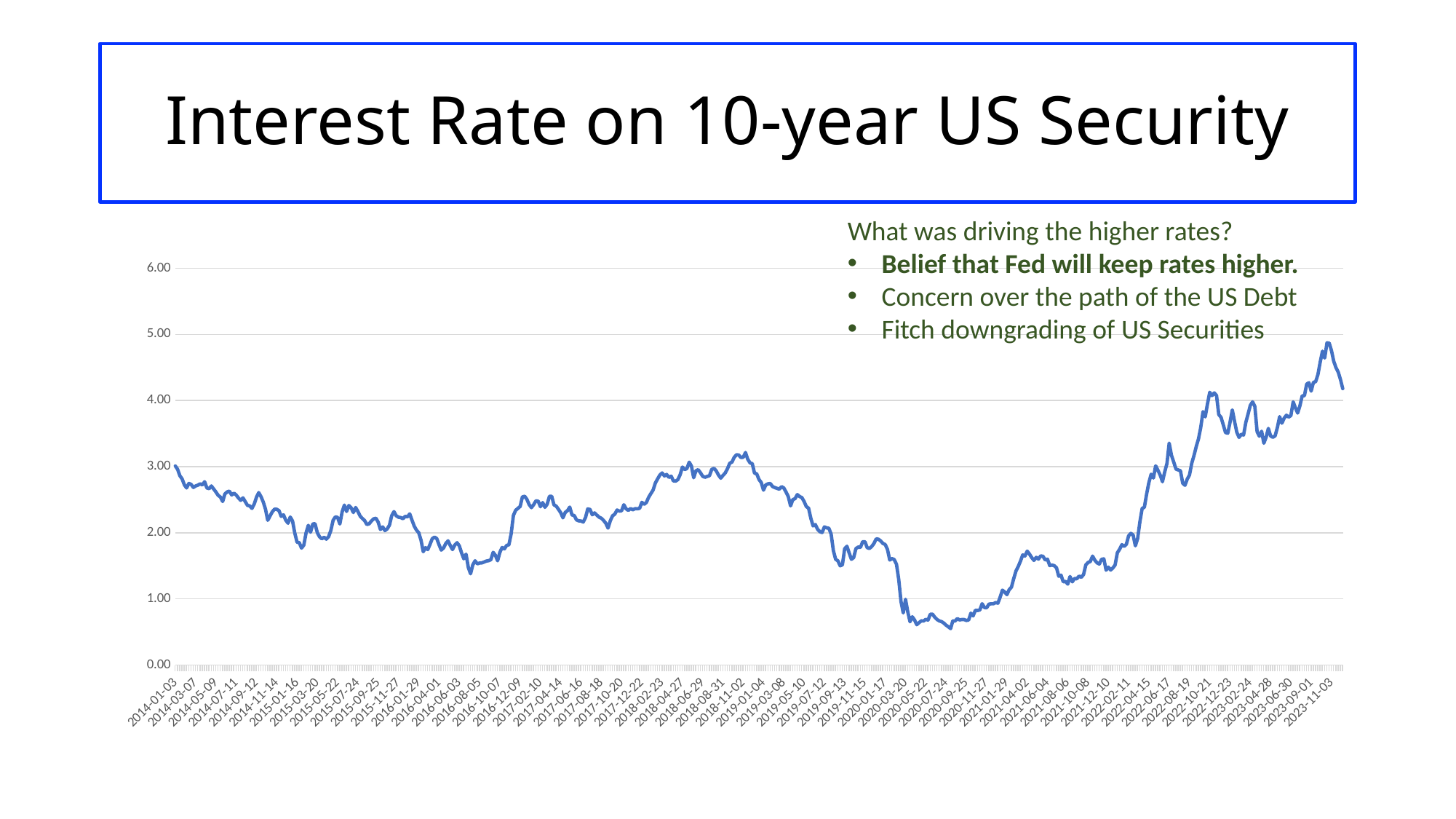
Is the interest rate around 2014-01-03 greater or less than 4.00? less Is the interest rate around 2016-08-05 greater or less than 2.00? less Is the interest rate around 2023-09-01 greater or less than 4.00? greater In which year does the line reach its lowest point? 2020 Does the interest rate rise or fall between 2018-11-02 and 2020-07-24? fall What colour is the line plotted on the chart? blue How many lines (series) are plotted on the chart? 1 What is the title of the slide containing the chart? Interest Rate on 10-year US Security In which year does the line reach its highest point? 2023 What kind of chart is shown on the slide? line chart